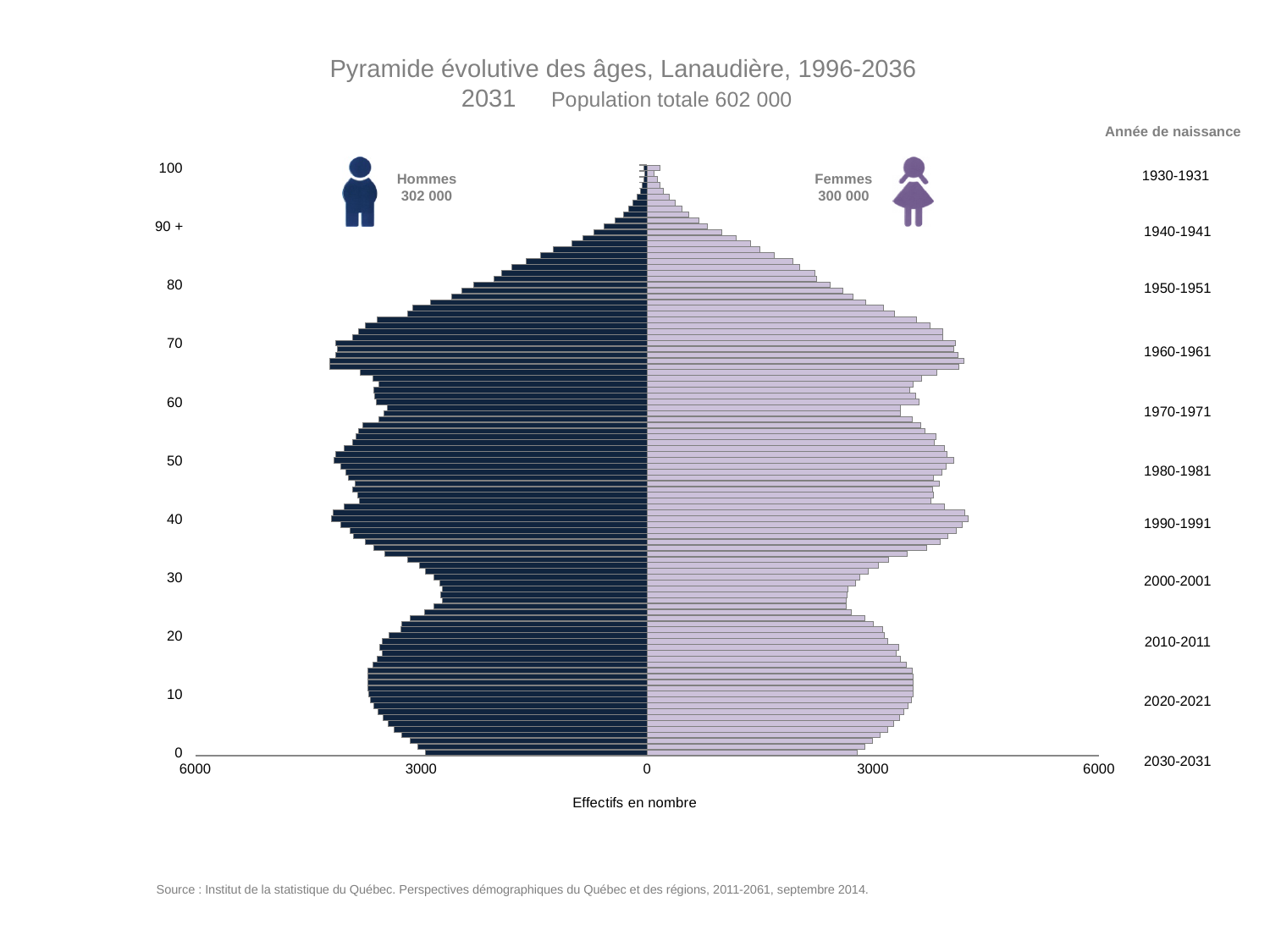
Is the value for Femmes at age 40 greater or less than 3000? greater What is the label of the horizontal axis? Effectifs en nombre What is the total population shown for 2031? 602 000 Which group is larger, Hommes or Femmes? Hommes What kind of chart is shown on the slide? bar chart Is the value for Hommes at age 70 greater or less than 3000? greater What is the number of Hommes shown on the chart? 302 000 Is the value for Hommes at age 90 greater or less than 3000? less How many population groups (series) does the chart show? 2 What is the number of Femmes shown on the chart? 300 000 What is the difference between the number of Hommes and the number of Femmes? 2 000 Do the bars for Hommes rise or fall as age increases from 70 to 100? fall